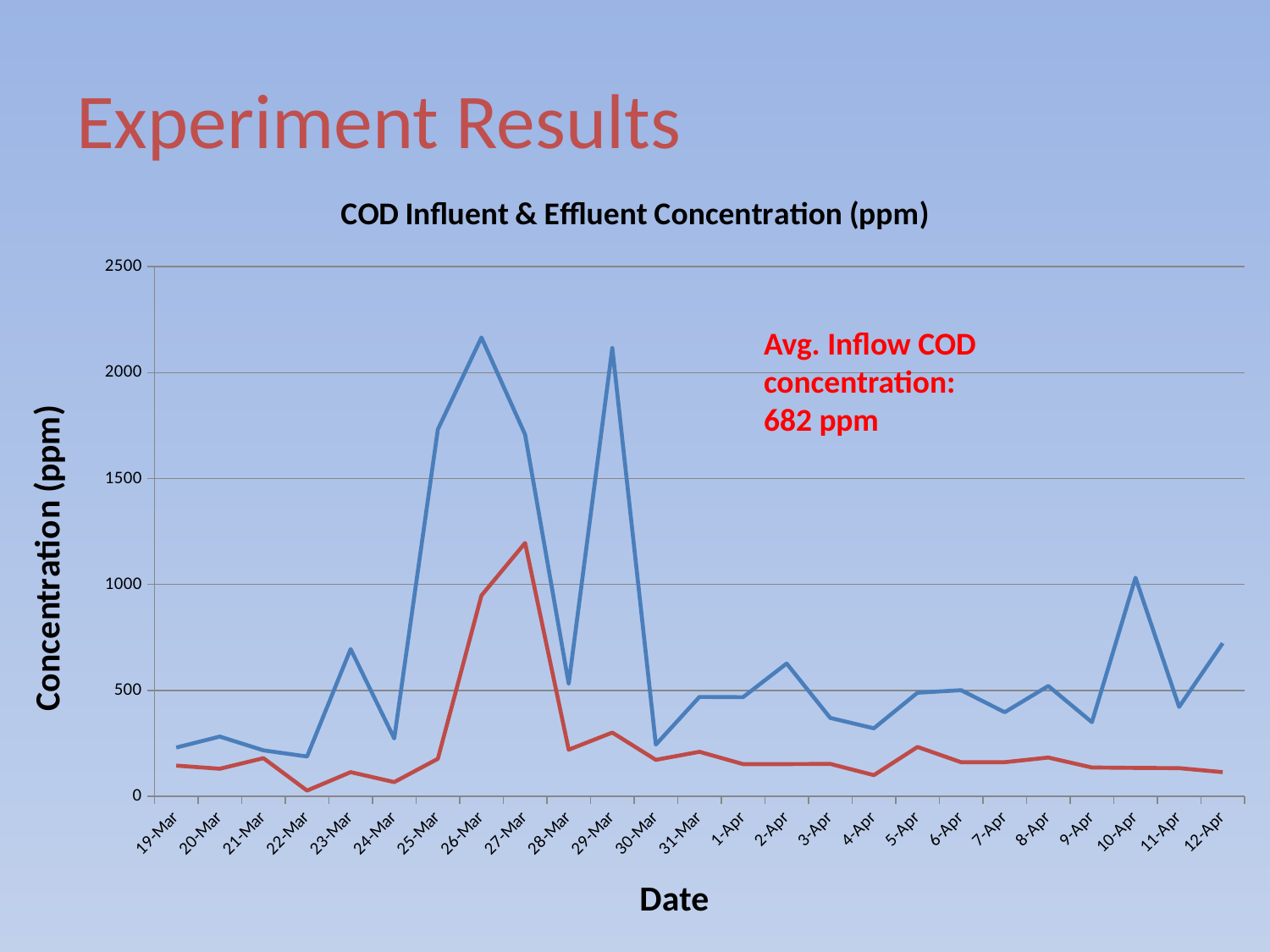
Is the value of the blue line on 19-Mar greater or less than 500? less On which date does the red line reach its lowest value? 22-Mar How many dates are shown along the x axis of the chart? 25 Is the value of the red line on 27-Mar greater or less than 1000? greater On which date does the red line reach its highest value? 27-Mar What is the title of the chart? COD Influent & Effluent Concentration (ppm) On 26-Mar, which line has the larger value, the blue line or the red line? blue line What is the average inflow COD concentration stated on the slide? 682 ppm Does the blue line rise or fall between 29-Mar and 30-Mar? fall What kind of chart is shown on the slide? line chart Is the value of the blue line on 26-Mar greater or less than 2000? greater